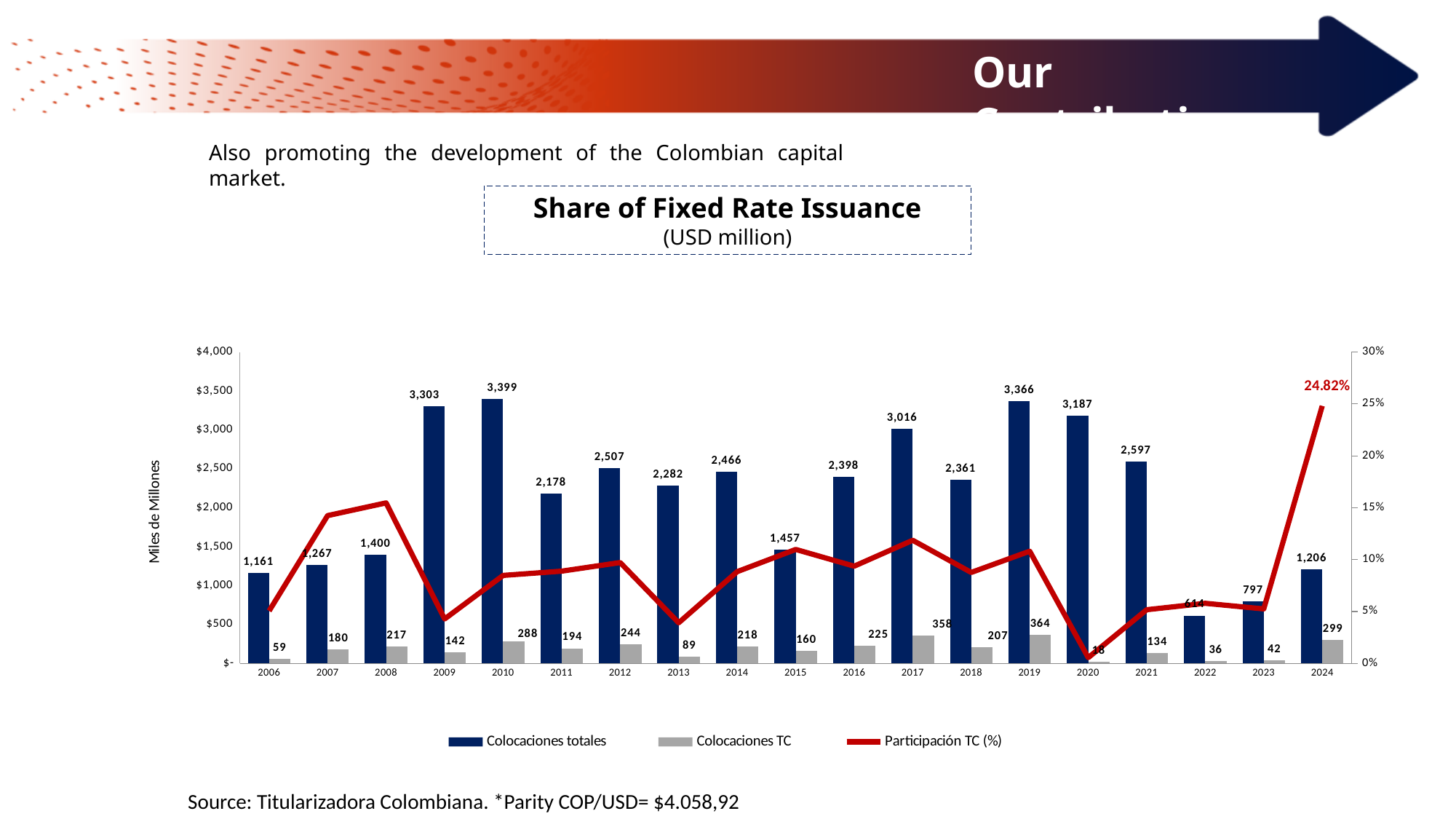
Which year has the lowest value for Colocaciones totales? 2022 What is the Participación TC (%) value labelled for 2024? 24.82% Which is larger: Colocaciones TC in 2017 or in 2012? 2017 What is the difference between Colocaciones totales in 2019 and 2020? 179 Which year has the lowest value for Colocaciones TC? 2020 What colour is the Participación TC (%) line? Red How many years are shown on the x axis? 19 How many series does the legend list? 3 Which year has the highest value for Colocaciones totales? 2010 Is the Participación TC (%) value for 2008 greater or less than 10%? greater What is the value of Colocaciones totales for 2010? 3,399 What is the value of Colocaciones TC for 2019? 364